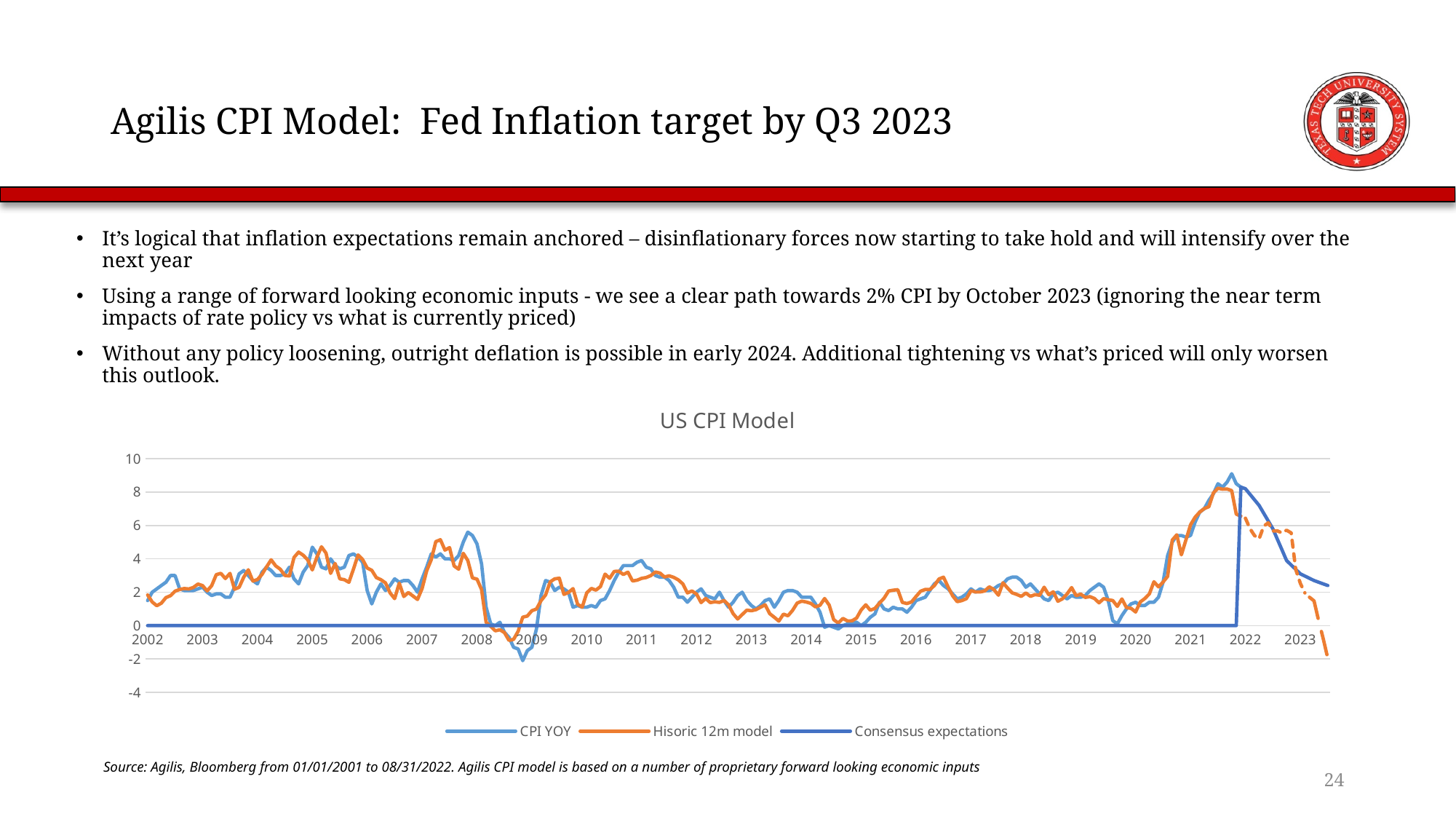
What kind of chart is shown on the slide? line chart How many year labels are shown on the x axis of the chart? 22 What are the three series named in the chart legend? CPI YOY, Hisoric 12m model, Consensus expectations Does CPI YOY rise or fall between 2020 and late 2021? rise Is the value of Consensus expectations at the end of 2023 greater or less than 4? less What is the title of the chart on the slide? US CPI Model Is the lowest value of CPI YOY around 2009 greater or less than 0? less Do Consensus expectations rise or fall from 2022 to 2023? fall How many series does the legend of the US CPI Model chart list? 3 Is the peak value of CPI YOY around late 2021 greater or less than 8? greater